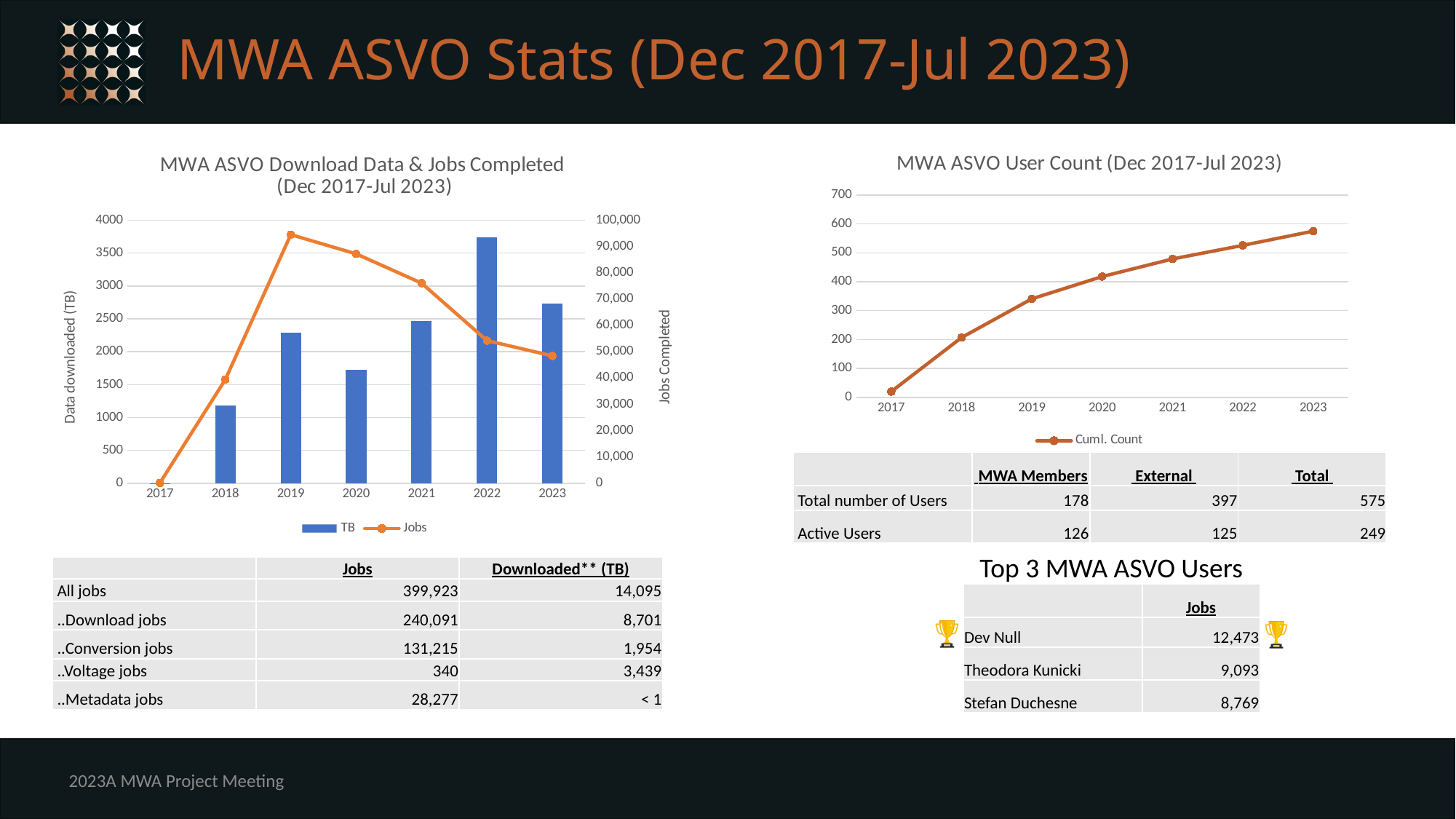
In the 'MWA ASVO Download Data & Jobs Completed' chart, is the TB value for 2022 greater or less than 3500? greater In the 'MWA ASVO Download Data & Jobs Completed' chart, which year has the lowest TB bar? 2017 In the 'MWA ASVO Download Data & Jobs Completed' chart, which year has the highest number of Jobs completed? 2019 In the 'MWA ASVO Download Data & Jobs Completed' chart, is the Jobs value for 2018 greater or less than 50,000? less In the 'MWA ASVO User Count' chart, is the value for 2023 greater or less than 600? less In the 'MWA ASVO Download Data & Jobs Completed' chart, how many series does the legend list? 2 In the 'MWA ASVO Download Data & Jobs Completed' chart, which year has the larger TB bar, 2020 or 2021? 2021 In the 'MWA ASVO Download Data & Jobs Completed' chart, which year has the tallest TB bar? 2022 In the 'MWA ASVO Download Data & Jobs Completed' chart, do the Jobs values rise or fall from 2019 to 2023? fall What kind of chart is the 'MWA ASVO User Count (Dec 2017-Jul 2023)' chart? line chart In the 'MWA ASVO Download Data & Jobs Completed' chart, how many years are shown on the x axis? 7 In the 'MWA ASVO User Count' chart, does the cumulative count rise or fall from 2017 to 2023? rise